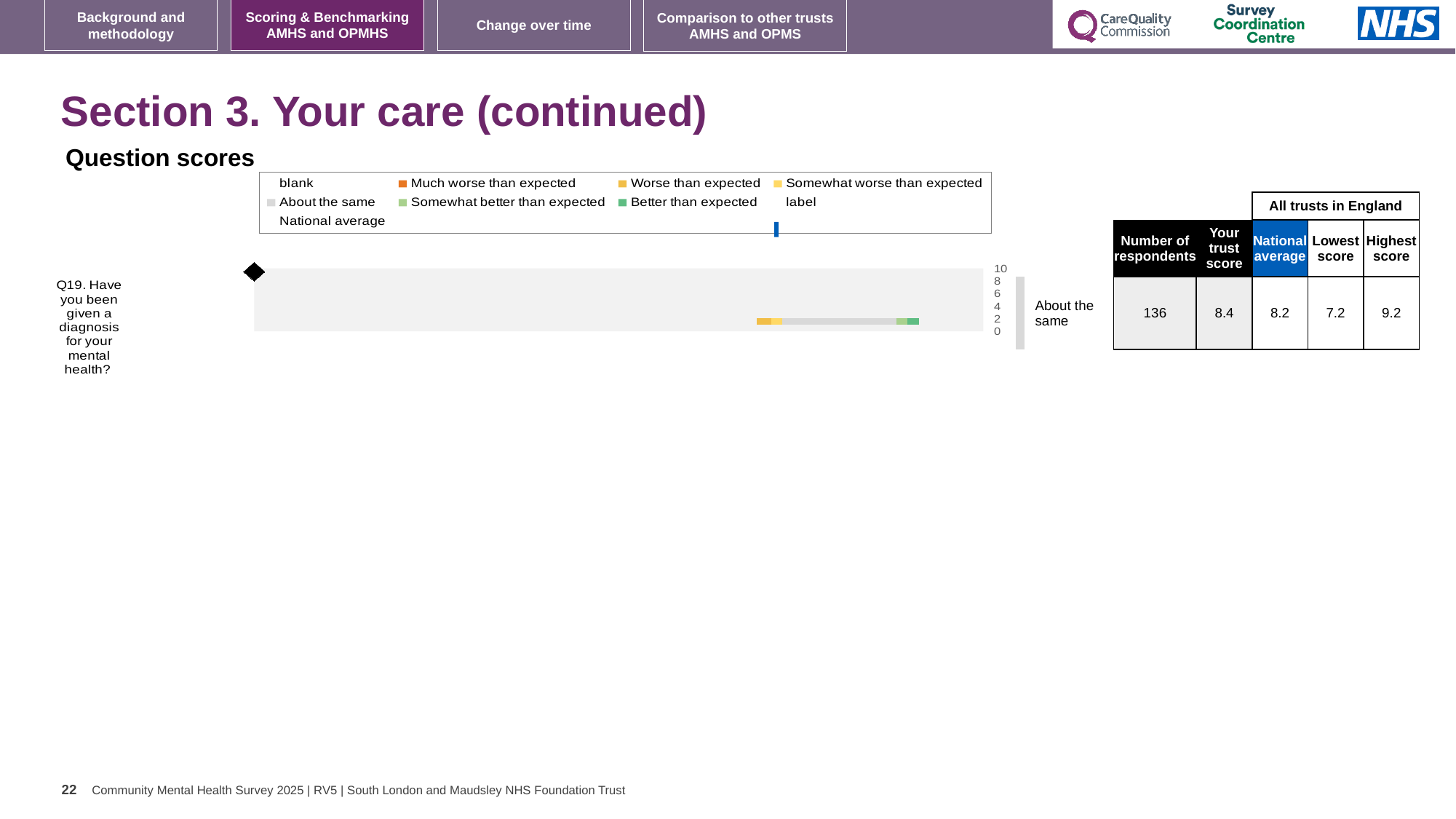
What is the national average score for Q19? 8.2 Which is larger for Q19, the trust's score or the national average? the trust's score What is the difference between the highest and lowest scores among all trusts in England for Q19? 2.0 What kind of chart is used to show the Q19 question score? bar chart What is the highest score among all trusts in England for Q19? 9.2 What is the trust's score for Q19? 8.4 How many respondents answered Q19? 136 What is the lowest score among all trusts in England for Q19? 7.2 Which question is plotted in the Question scores chart? Q19. Have you been given a diagnosis for your mental health? How many questions are plotted in the Question scores chart? 1 What is the difference between the trust's score and the national average for Q19? 0.2 What benchmark category is shown next to the bar for Q19? About the same